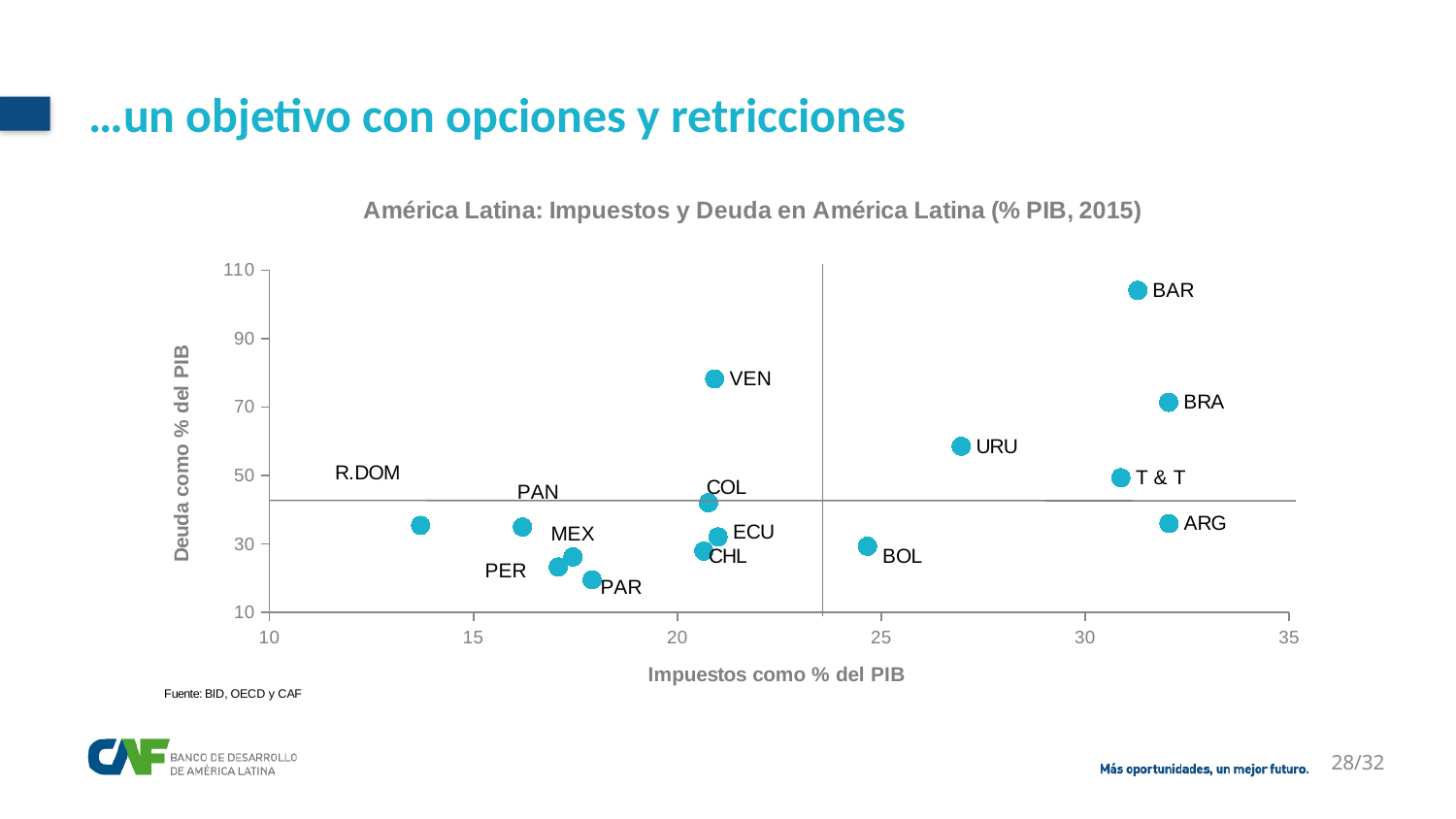
How many countries are plotted on the chart? 15 Is the debt value for VEN greater or less than 70? greater Which country has the lowest debt as % of GDP on the chart? PAR What is the label of the vertical axis? Deuda como % del PIB Which has a higher debt as % of GDP, VEN or URU? VEN What is the title of the chart? América Latina: Impuestos y Deuda en América Latina (% PIB, 2015) Is the debt value for BAR greater or less than 90? greater Is the tax value for BRA greater or less than 30? greater Which country has the highest debt as % of GDP on the chart? BAR What kind of chart is shown on the slide? scatter chart Which country has the lowest taxes as % of GDP on the chart? R.DOM